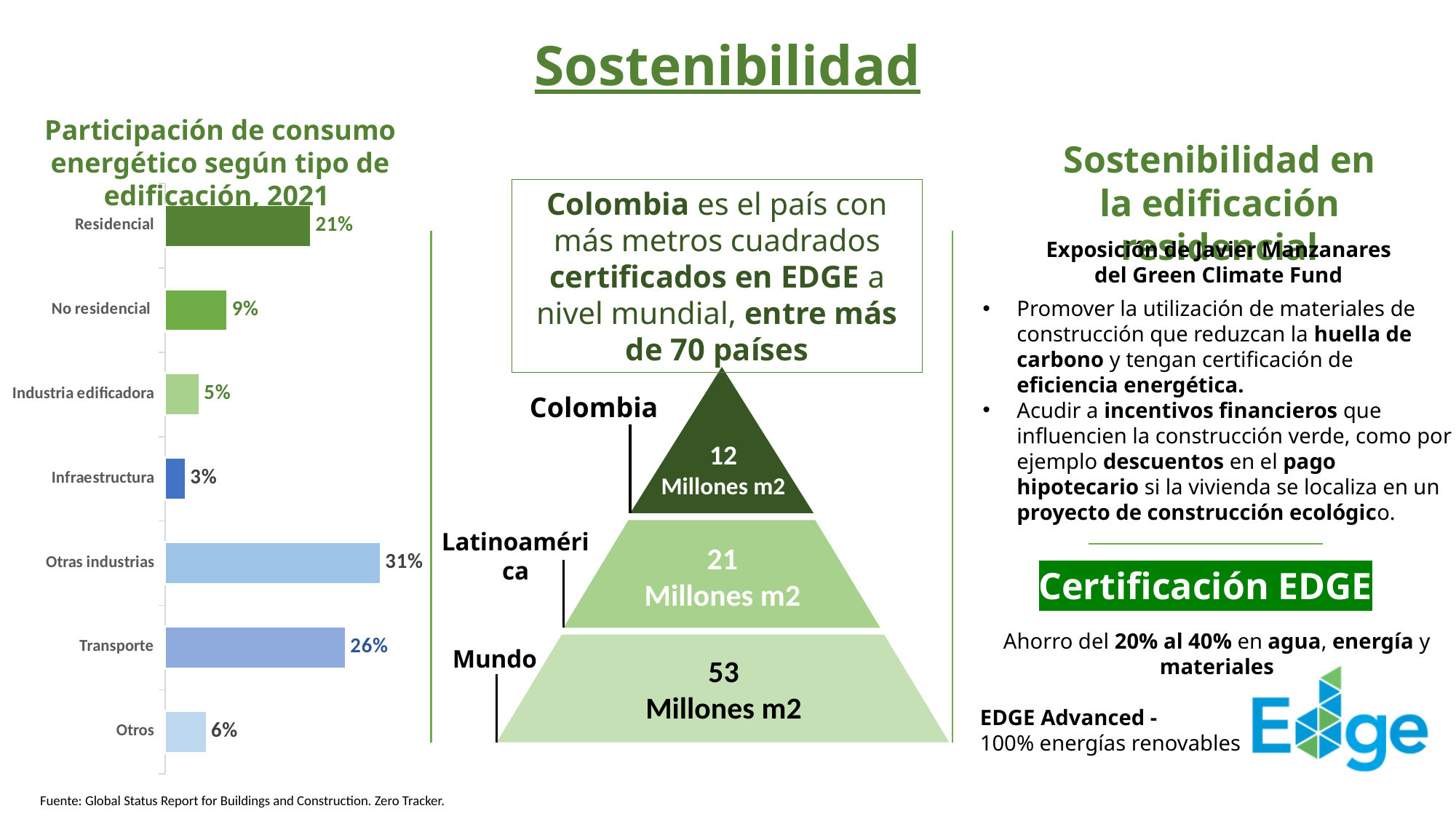
What is the difference between the values for Otras industrias and Transporte in the bar chart? 5% Which is larger in the bar chart, the value for Otros or the value for No residencial? No residencial What is the title of the bar chart? Participación de consumo energético según tipo de edificación, 2021 Which category has the highest value in the bar chart? Otras industrias What kind of chart is used to show the energy consumption share by building type? Bar chart Which category has the lowest value in the bar chart? Infraestructura What is the difference between the values for Residencial and No residencial in the bar chart? 12% How many categories are shown in the bar chart? 7 What is the value for Industria edificadora in the bar chart? 5% What is the value for Transporte in the bar chart? 26% What is the value for Residencial in the bar chart? 21% What is the value for Infraestructura in the bar chart? 3%